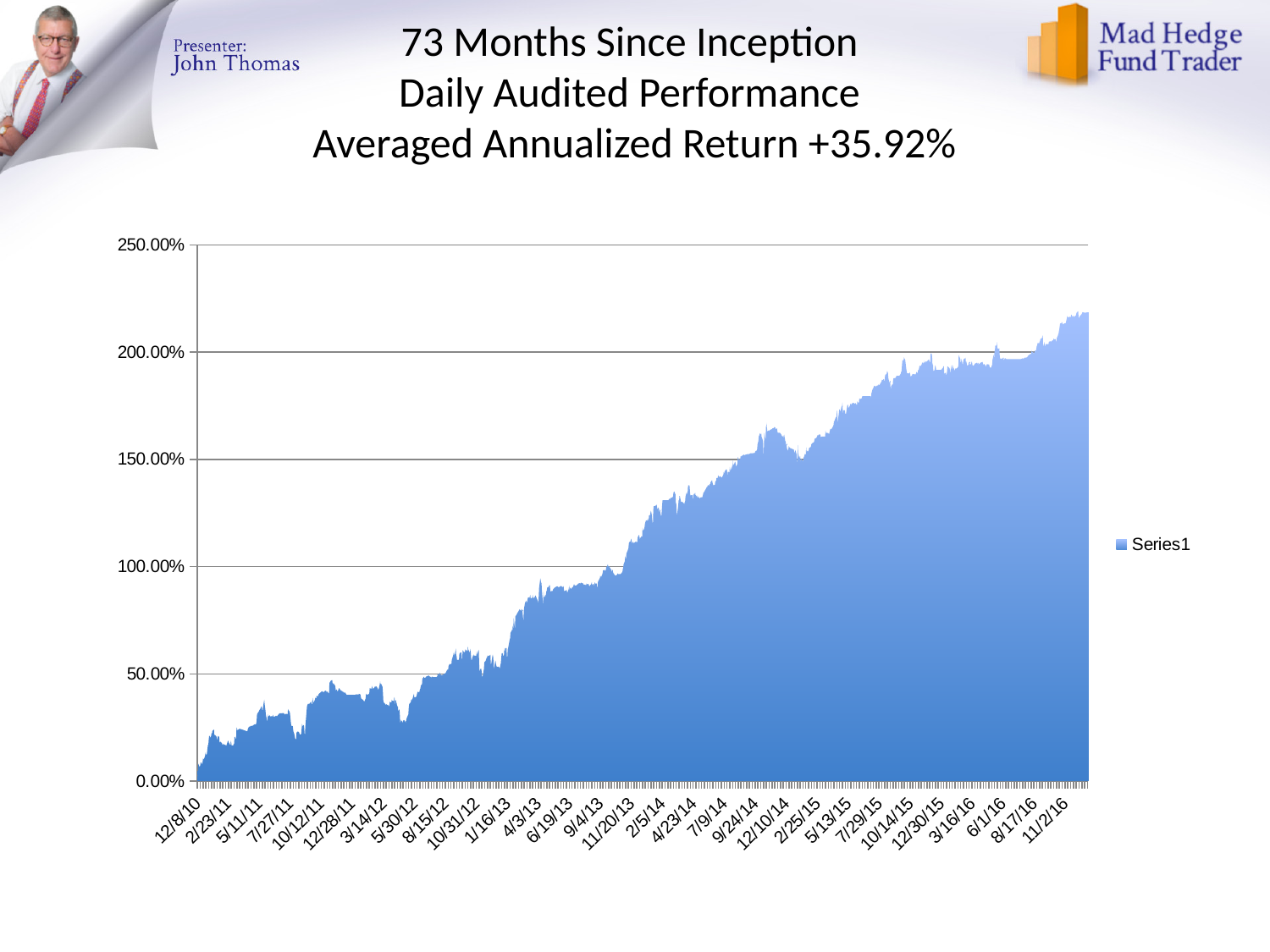
Do the values generally rise or fall from 12/8/10 to 11/2/16? rise Is the value at 2/5/14 greater or less than 100.00%? greater Is the value at 6/19/13 greater or less than 100.00%? less Is the value at 11/2/16 greater or less than 200.00%? greater What kind of chart is shown on the slide? area chart How many series does the chart legend list? 1 Which is larger, the value at 11/2/16 or the value at 12/8/10? 11/2/16 What is the highest tick shown on the vertical axis? 250.00% What is the name of the series shown in the legend? Series1